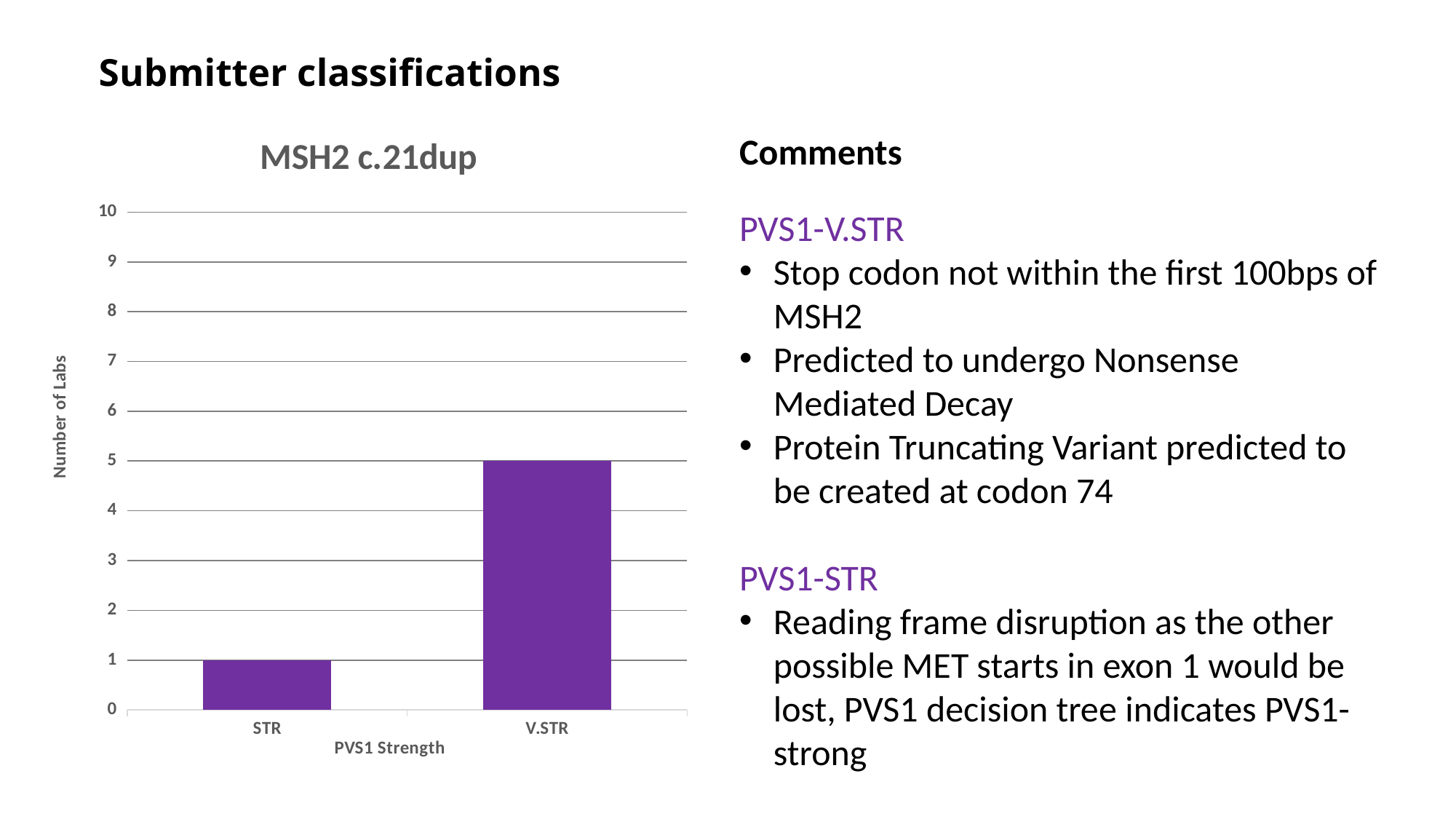
How many categories are shown on the x axis of the chart? 2 What is the label of the y axis? Number of Labs Which PVS1 strength category has the lowest number of labs? STR What is the difference in number of labs between V.STR and STR? 4 What is the number of labs for STR? 1 Which has more labs, STR or V.STR? V.STR Which PVS1 strength category has the highest number of labs? V.STR What is the number of labs for V.STR? 5 Is the value for V.STR greater or less than 4? greater What is the highest value shown on the y axis? 10 What is the title of the chart? MSH2 c.21dup What kind of chart is shown on the slide? bar chart